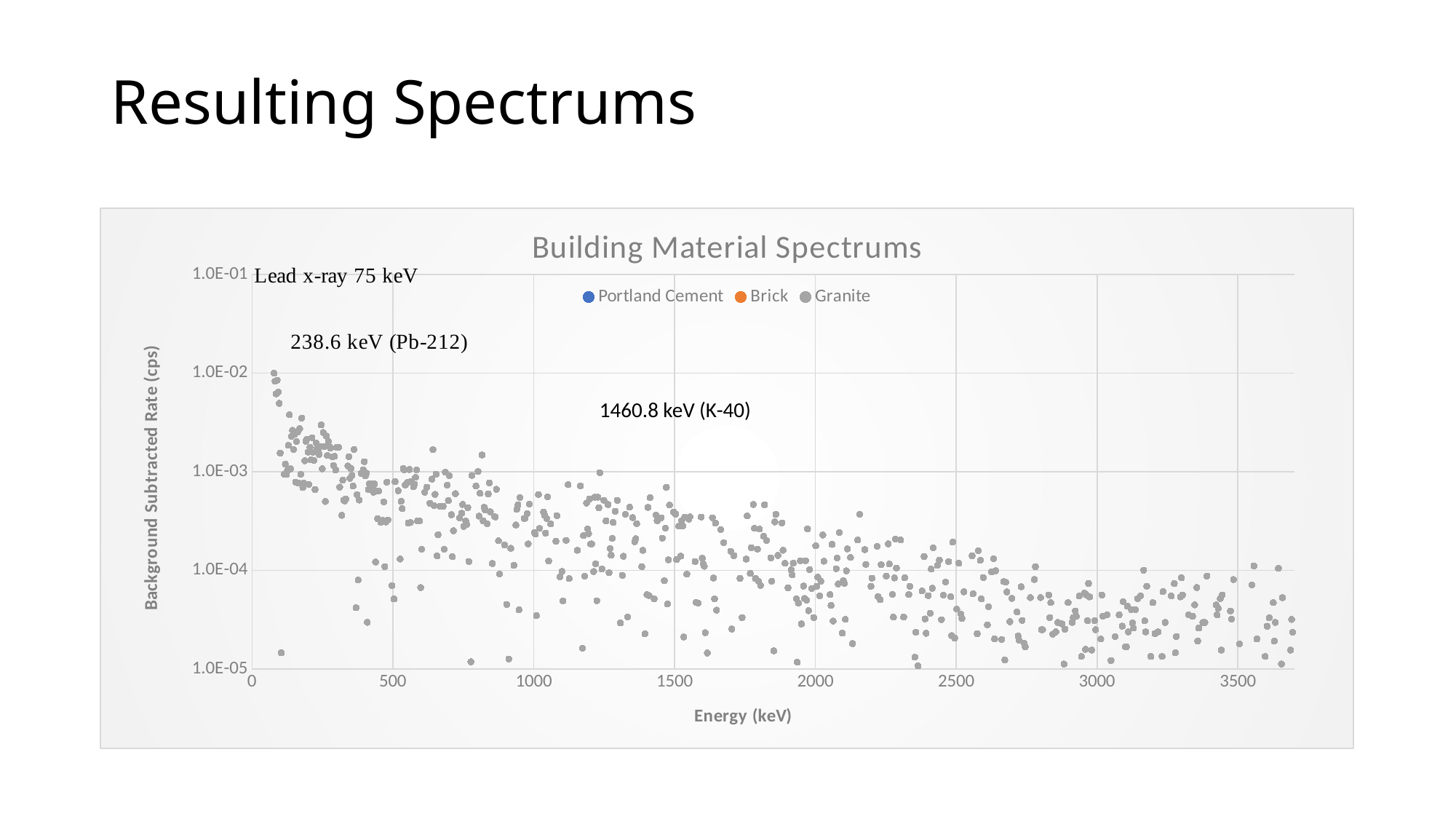
How many series does the chart's legend list? 3 What is the highest value shown on the y axis? 1.0E-01 What is the largest energy value labelled on the x axis? 3500 Do the plotted values generally rise or fall as energy increases along the x axis? fall What kind of chart is shown on the slide? scatter chart What is the title of the chart? Building Material Spectrums